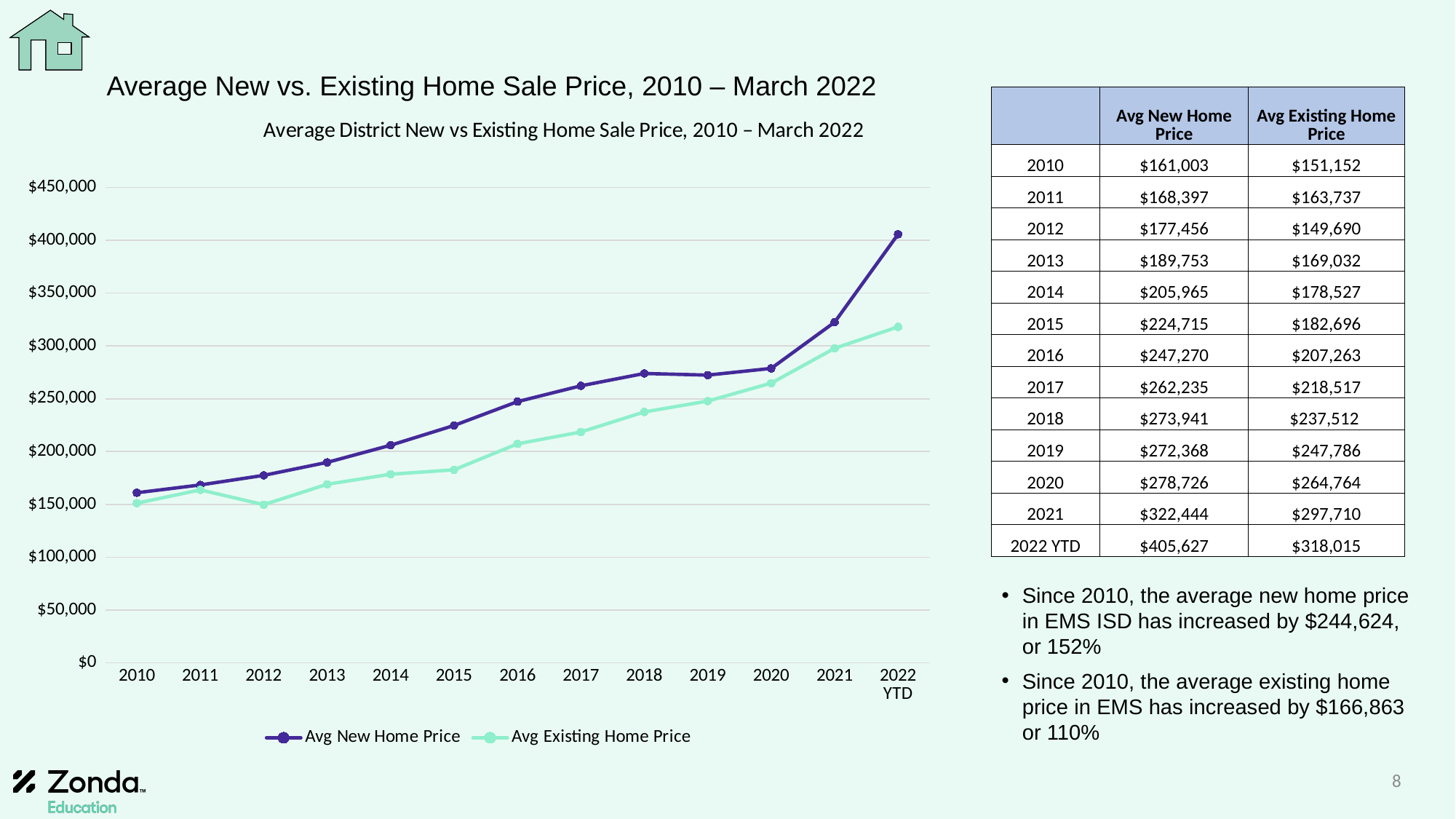
What is the Avg Existing Home Price for 2016? $207,263 Which year has the highest Avg New Home Price? 2022 YTD What is the difference between the Avg New Home Price and the Avg Existing Home Price in 2021? $24,734 Is the Avg Existing Home Price for 2015 greater or less than $200,000? less How many years (points) are plotted along the x axis of the chart? 13 What is the Avg New Home Price for 2022 YTD? $405,627 What kind of chart is shown on the slide? line chart How many series does the chart legend list? 2 Which year has the lowest Avg Existing Home Price? 2012 Does the Avg New Home Price generally rise or fall from 2010 to 2022 YTD? rise Which is larger in 2019, the Avg New Home Price or the Avg Existing Home Price? Avg New Home Price Is the Avg New Home Price for 2022 YTD greater or less than $400,000? greater